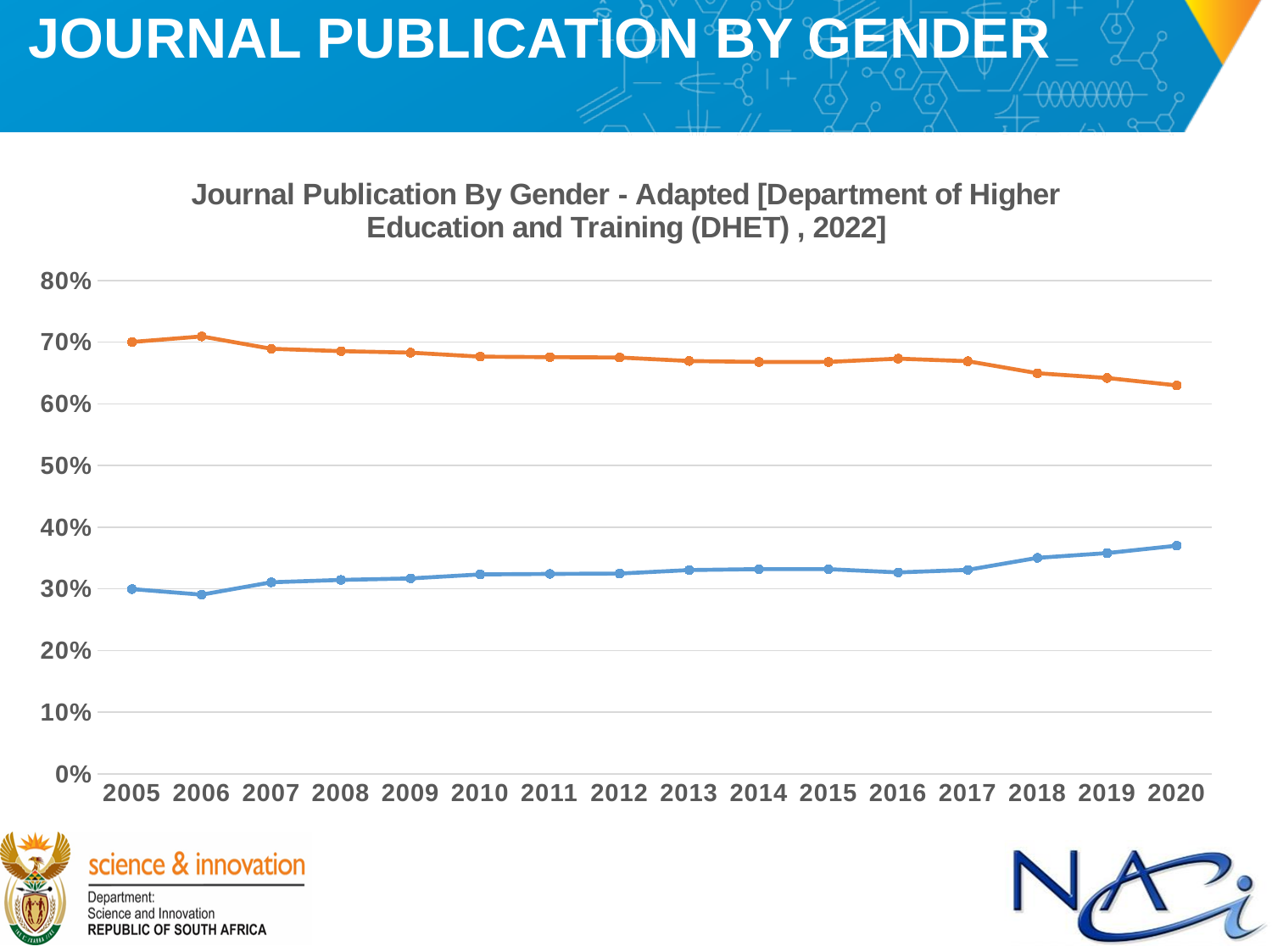
Does the orange line rise or fall from 2005 to 2020? Fall In which year does the blue line reach its highest value? 2020 Is the value of the orange line in 2020 greater or less than 60%? greater What is the title of the chart? Journal Publication By Gender - Adapted [Department of Higher Education and Training (DHET) , 2022] What is the first year shown on the x axis? 2005 How many years are shown along the x axis of the chart? 16 Is the value of the orange line in 2020 greater or less than 70%? less How many lines are plotted on the chart? 2 In 2020, which line has the higher value, the orange line or the blue line? Orange line What kind of chart is shown on the slide? Line chart Is the value of the blue line in 2020 greater or less than 40%? less Does the blue line rise or fall from 2005 to 2020? Rise